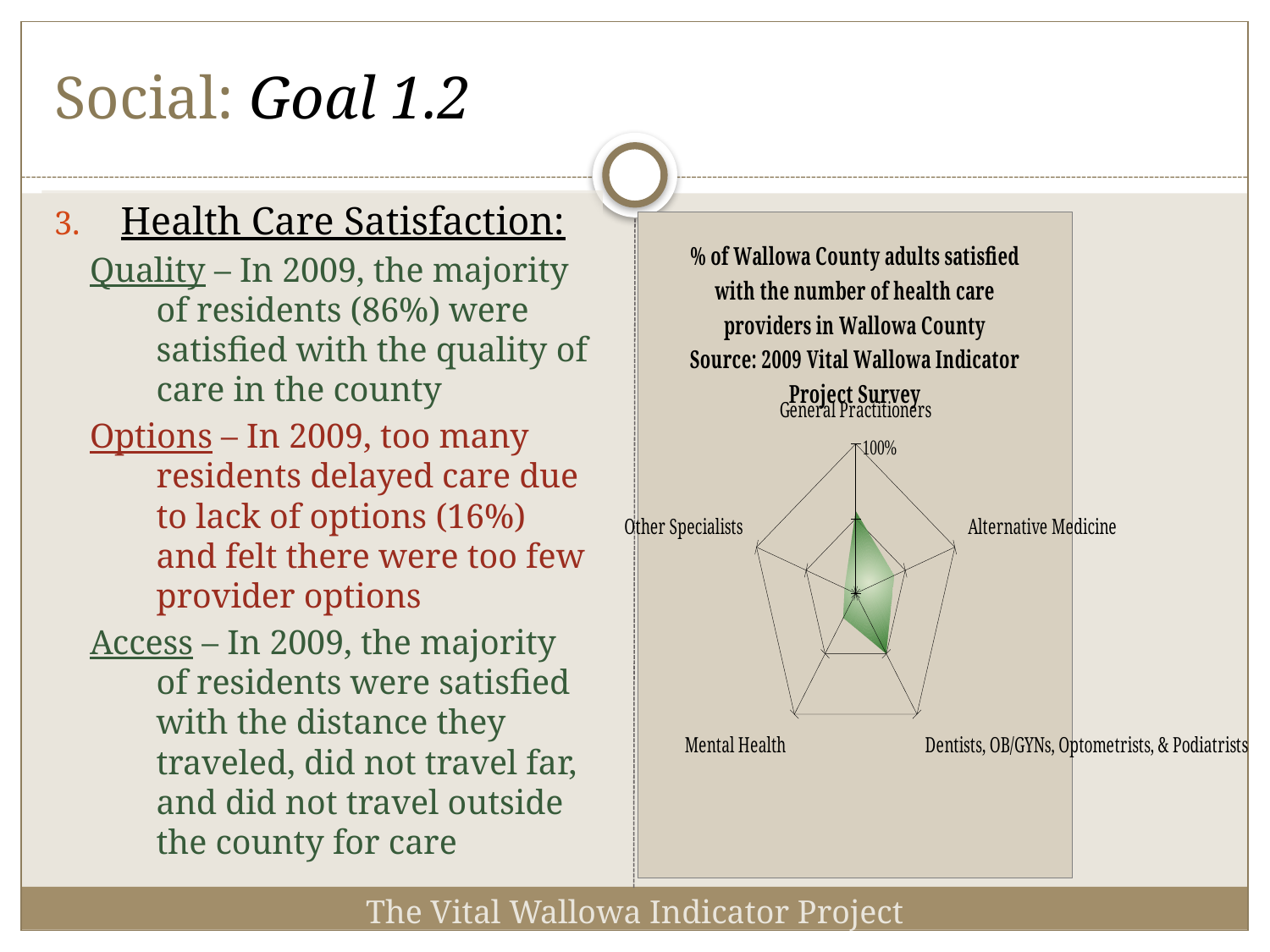
Which category has the highest value in the radar chart? General Practitioners Which is larger in the radar chart: the value for Dentists, OB/GYNs, Optometrists, & Podiatrists or the value for Mental Health? Dentists, OB/GYNs, Optometrists, & Podiatrists Is the value for General Practitioners greater or less than 100%? less What source is cited in the chart title? 2009 Vital Wallowa Indicator Project Survey How many categories (axes) does the radar chart have? 5 What kind of chart is shown on the slide? Radar chart Which is larger in the radar chart: the value for Alternative Medicine or the value for Other Specialists? Alternative Medicine Which is larger in the radar chart: the value for General Practitioners or the value for Mental Health? General Practitioners What is the only percentage tick label printed on the radar chart's axis? 100%